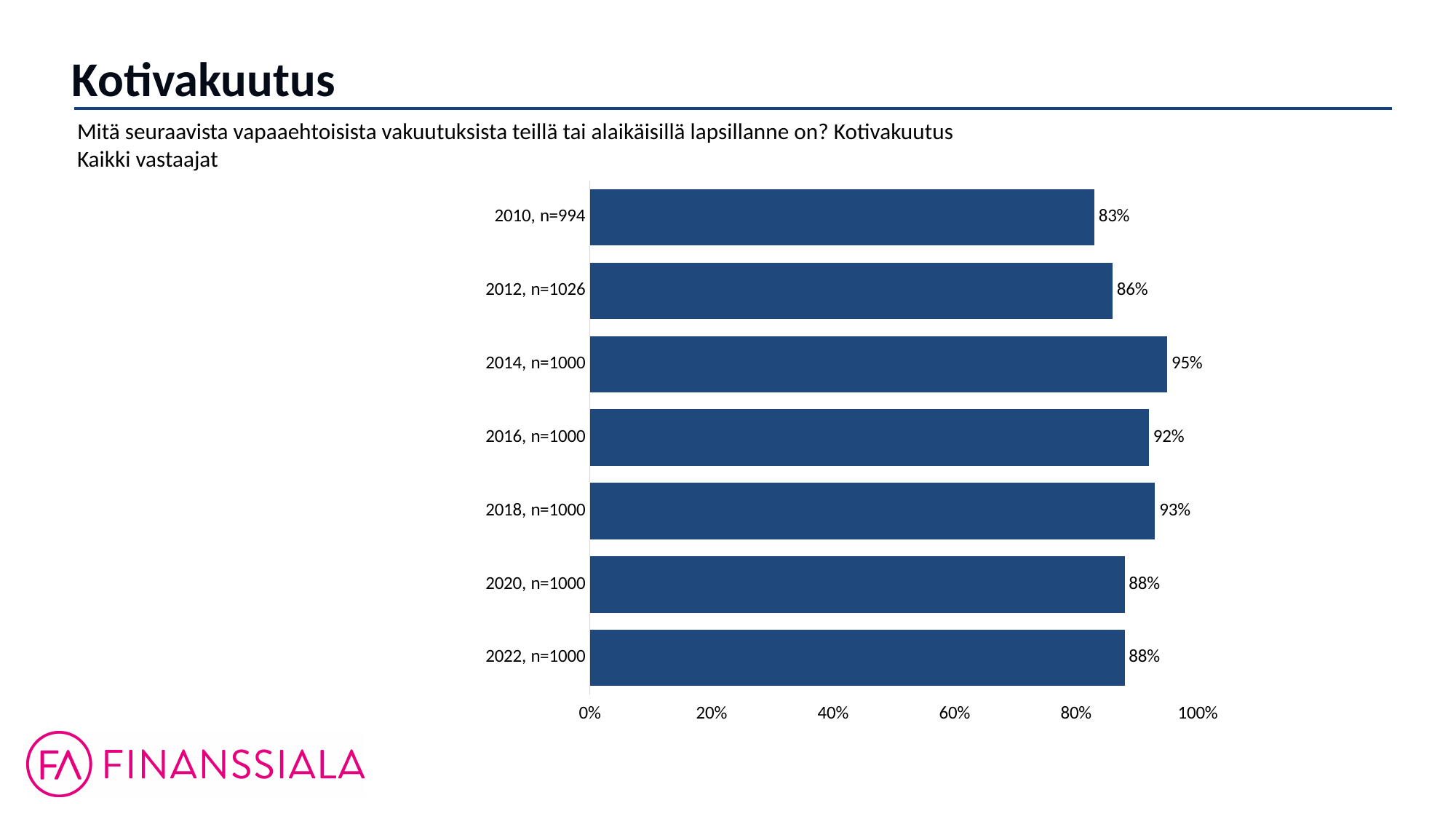
What is the value for 2010, n=994? 83% Which is larger, the value for 2016 or the value for 2020? 2016 Did the value rise or fall from 2018 to 2020? Fall How many bars are shown in the chart? 7 What is the value for 2022, n=1000? 88% Which year has the highest value? 2014, n=1000 What is the value for 2014, n=1000? 95% What kind of chart is shown on the slide? Bar chart Which year has the lowest value? 2010, n=994 What is the difference between the values for 2014 and 2010? 12 percentage points What is the title of the slide? Kotivakuutus Is the value for 2012, n=1026 greater or less than 80%? greater